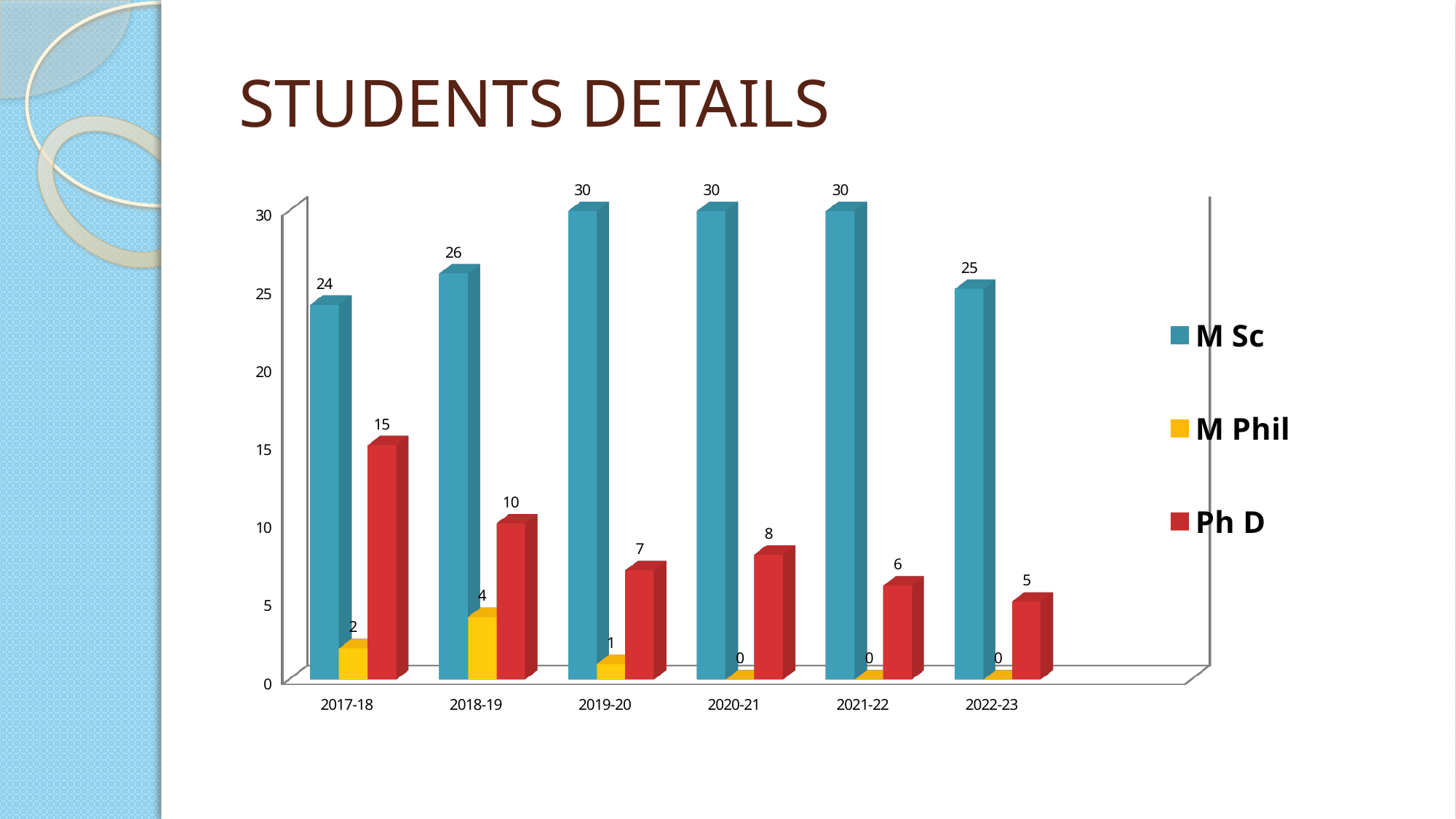
Which is larger, the Ph D value for 2020-21 or the Ph D value for 2021-22? 2020-21 What is the title of the slide? STUDENTS DETAILS What kind of chart is shown on the slide? Bar chart Do the Ph D values rise or fall from 2017-18 to 2022-23? Fall How many years are shown on the x axis? 6 What is the M Sc value for 2018-19? 26 What is the difference between the M Sc and Ph D values for 2022-23? 20 What is the Ph D value for 2017-18? 15 How many series does the legend list? 3 What is the M Phil value for 2019-20? 1 Which year has the lowest M Sc value? 2017-18 Which year has the highest Ph D value? 2017-18